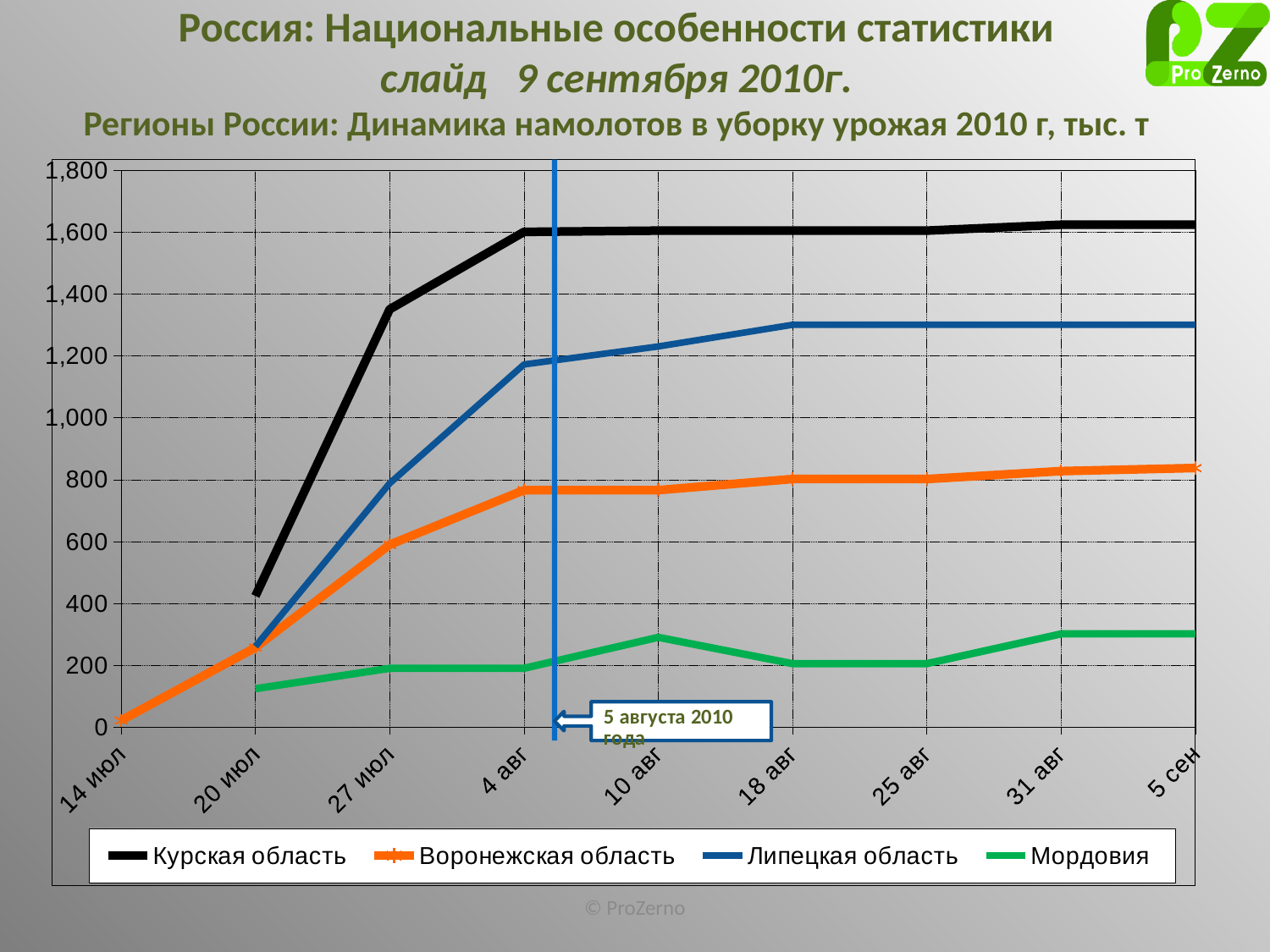
How many dates are shown on the x axis? 9 What colour is the line for Курская область? black Is the value for Курская область on 20 июл greater or less than 600? less On 5 сен, which is larger: Липецкая область or Воронежская область? Липецкая область Which region has the highest value on 5 сен? Курская область What kind of chart is shown on the slide? line chart How many series does the legend list? 4 Is the value for Курская область on 5 сен greater or less than 1,400? greater Which region has the lowest value on 5 сен? Мордовия Is the value for Мордовия on 20 июл greater or less than 200? less Do the values for Воронежская область rise or fall from 14 июл to 5 сен? rise